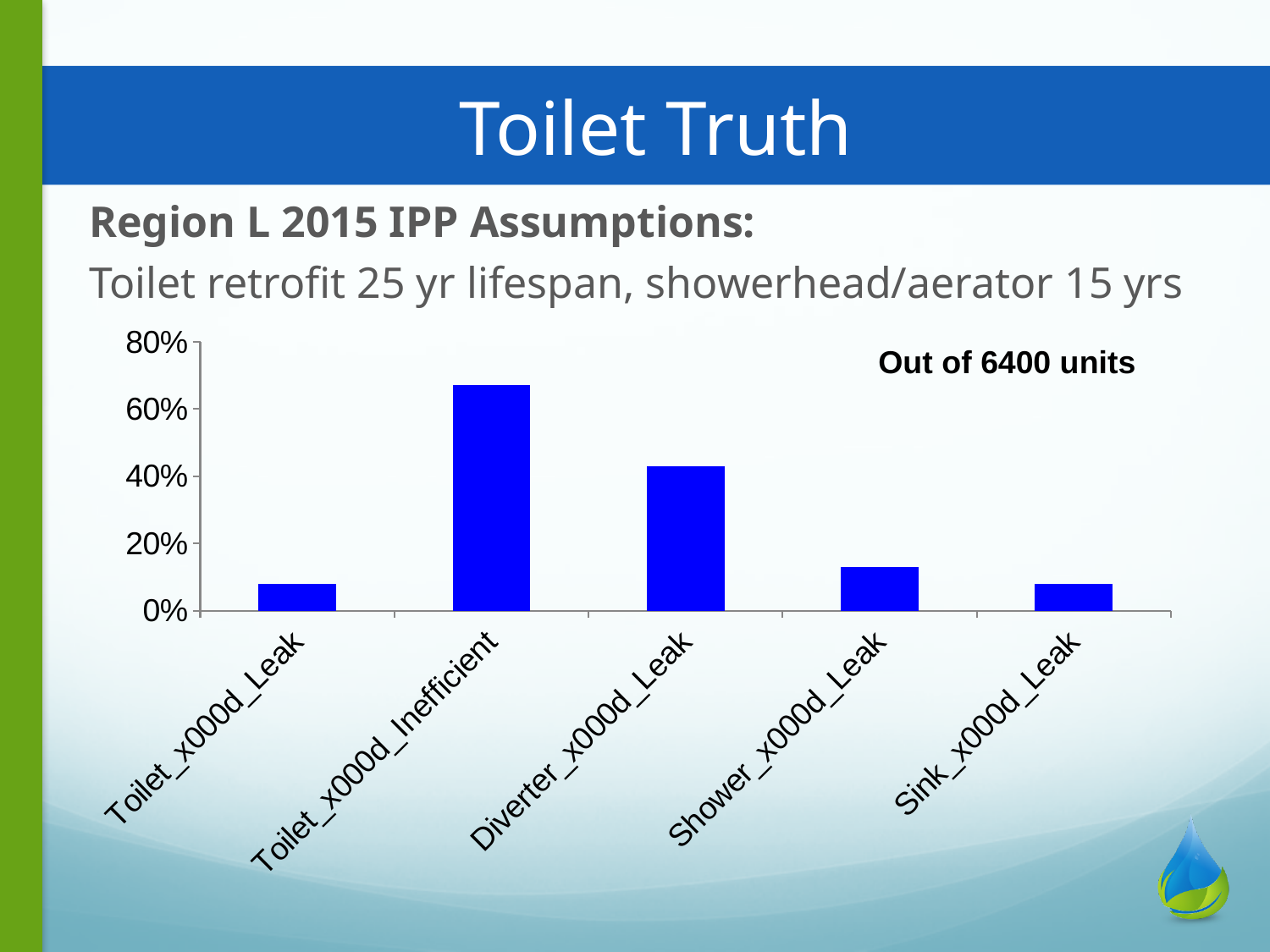
Is the value for Shower_x000d_Leak greater or less than 20%? less Which category has the highest value in the chart? Toilet_x000d_Inefficient What kind of chart is shown on the slide? bar chart According to the note on the chart, out of how many units are the percentages calculated? 6400 units Which is larger, the value for Shower_x000d_Leak or the value for Diverter_x000d_Leak? Diverter_x000d_Leak What is the highest value shown on the chart's vertical axis? 80% Which is larger, the value for Toilet_x000d_Inefficient or the value for Diverter_x000d_Leak? Toilet_x000d_Inefficient Is the value for Toilet_x000d_Leak greater or less than 20%? less Is the value for Sink_x000d_Leak greater or less than 20%? less How many categories are plotted in the chart? 5